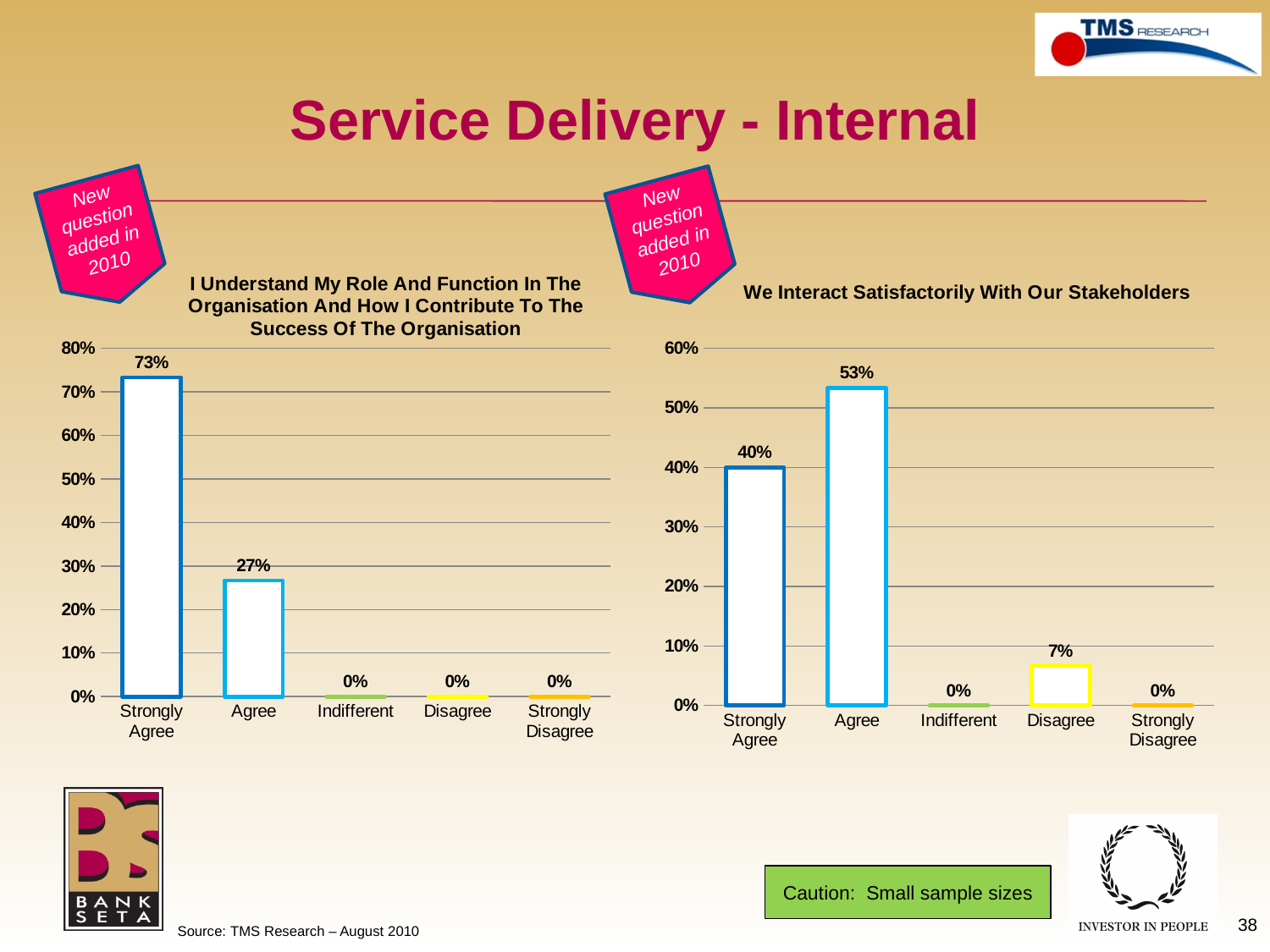
In the right chart ('We Interact Satisfactorily With Our Stakeholders'), what is the value for Disagree? 7% In the right chart ('We Interact Satisfactorily With Our Stakeholders'), what is the value for Agree? 53% In the right chart ('We Interact Satisfactorily With Our Stakeholders'), what is the difference between Agree and Strongly Agree? 13% What kind of chart is the right chart ('We Interact Satisfactorily With Our Stakeholders')? Bar chart In the left chart ('I Understand My Role And Function In The Organisation...'), what is the value for Strongly Agree? 73% In the left chart ('I Understand My Role And Function In The Organisation...'), which category has the highest value? Strongly Agree How many categories are shown on the x axis of the left chart ('I Understand My Role And Function In The Organisation...')? 5 In the right chart ('We Interact Satisfactorily With Our Stakeholders'), what is the value for Indifferent? 0% In the left chart ('I Understand My Role And Function In The Organisation...'), what is the difference between Strongly Agree and Agree? 46% In the left chart ('I Understand My Role And Function In The Organisation...'), what is the value for Agree? 27% In the right chart ('We Interact Satisfactorily With Our Stakeholders'), which category has the highest value? Agree In the right chart ('We Interact Satisfactorily With Our Stakeholders'), which is larger, Strongly Agree or Disagree? Strongly Agree